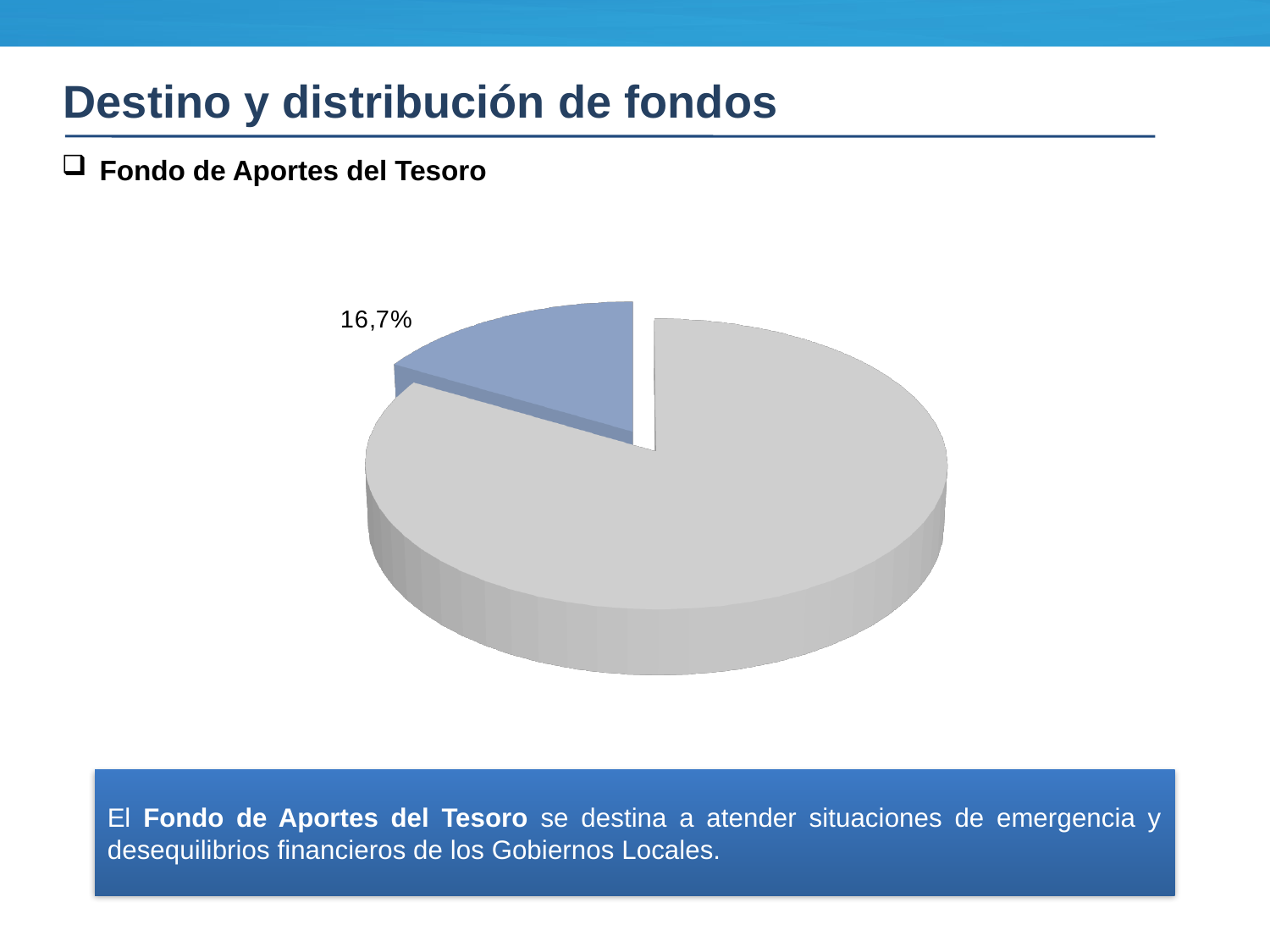
Which fund does the pie chart on the slide refer to, according to the heading above it? Fondo de Aportes del Tesoro What percentage is printed on the blue slice of the pie chart? 16,7% How many slices of the pie chart have a data label printed? 1 What share of the pie does the blue, separated slice represent? 16,7% What colour is the slice that is pulled out from the rest of the pie? blue Which slice of the pie chart is larger, the grey one or the blue one? the grey one Is the grey slice of the pie chart greater or less than 50% of the pie? greater Which slice of the pie chart is the smallest? the blue slice (16,7%) What kind of chart is shown on the slide? pie chart How many slices does the pie chart have? 2 Is the blue slice of the pie chart greater or less than 20% of the pie? less